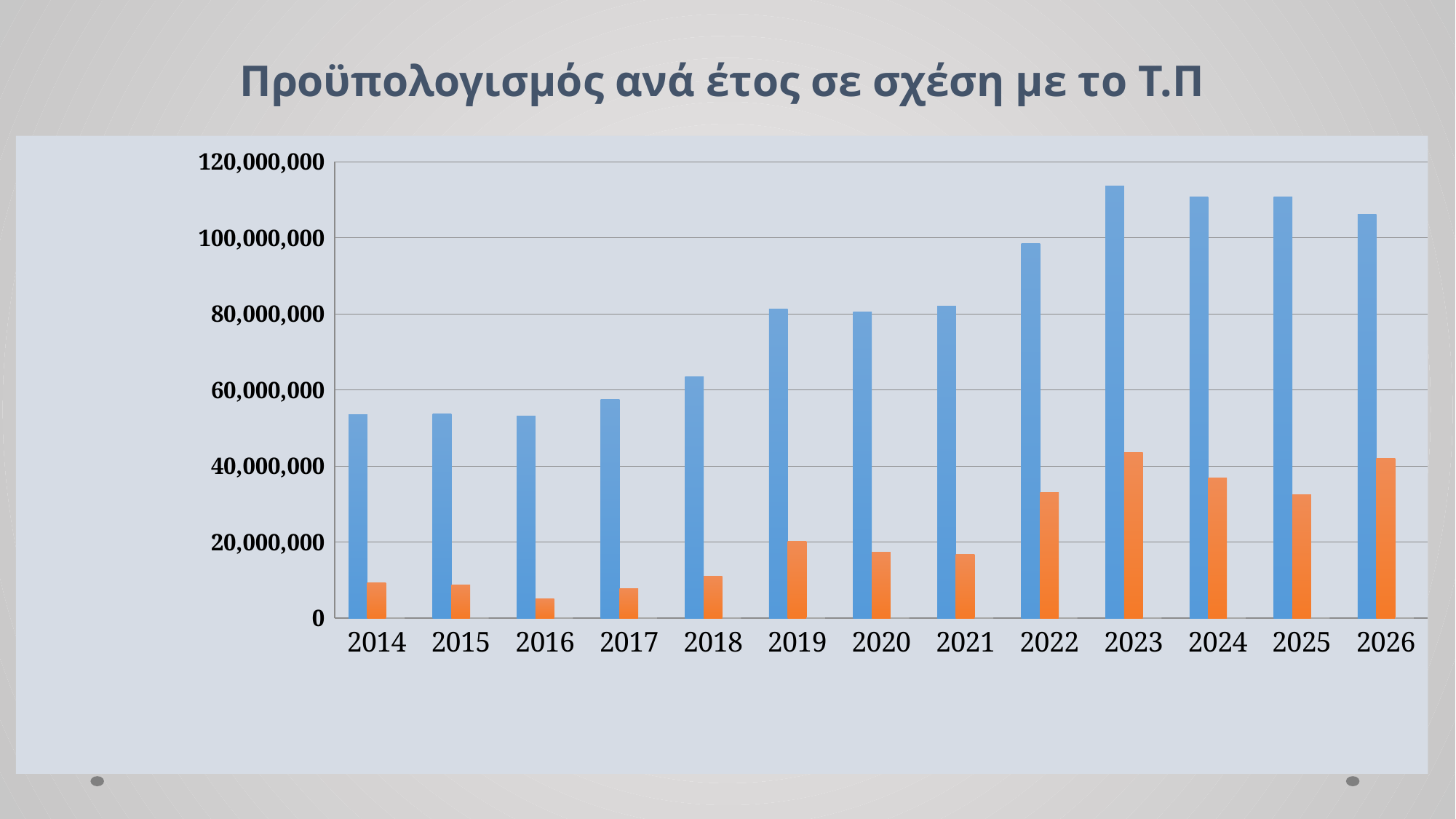
In which year is the blue bar the highest? 2023 In which year is the orange bar the lowest? 2016 Do the blue bars generally rise or fall from 2014 to 2023? Rise How many bar series (colours) are plotted for each year? 2 Which is larger, the blue bar for 2017 or the blue bar for 2019? 2019 What kind of chart is shown on the slide? Bar chart Is the blue bar for 2022 greater or less than 80,000,000? greater How many years are shown on the x axis of the chart? 13 Is the orange bar for 2022 greater or less than 20,000,000? greater Is the blue bar for 2014 greater or less than 60,000,000? less What is the title of the chart? Προϋπολογισμός ανά έτος σε σχέση με το Τ.Π